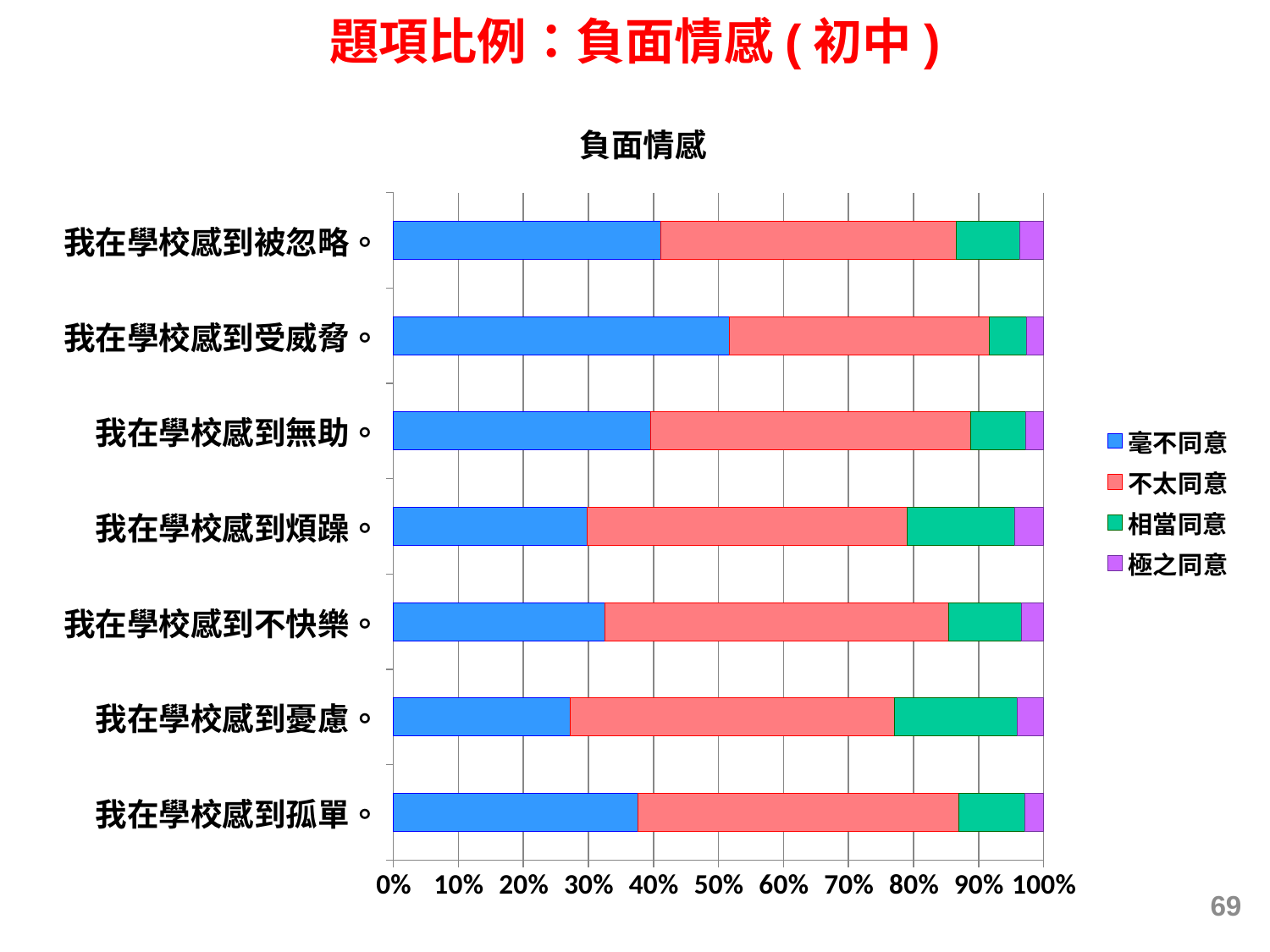
Which has a larger 毫不同意 segment: 我在學校感到無助。 or 我在學校感到煩躁。? 我在學校感到無助。 Which statement has the largest 毫不同意 segment? 我在學校感到受威脅。 How many series does the legend list? 4 What is the title shown above the chart? 負面情感 Is the 毫不同意 value for 我在學校感到受威脅。 greater or less than 50%? greater Which statement has the smallest 毫不同意 segment? 我在學校感到憂慮。 Which legend entry is shown in green? 相當同意 Is the 毫不同意 value for 我在學校感到孤單。 greater or less than 40%? less How many statements (categories) are plotted in the chart? 7 Which has a larger 毫不同意 segment: 我在學校感到受威脅。 or 我在學校感到憂慮。? 我在學校感到受威脅。 What kind of chart is shown on the slide? stacked bar chart Is the 毫不同意 value for 我在學校感到憂慮。 greater or less than 30%? less